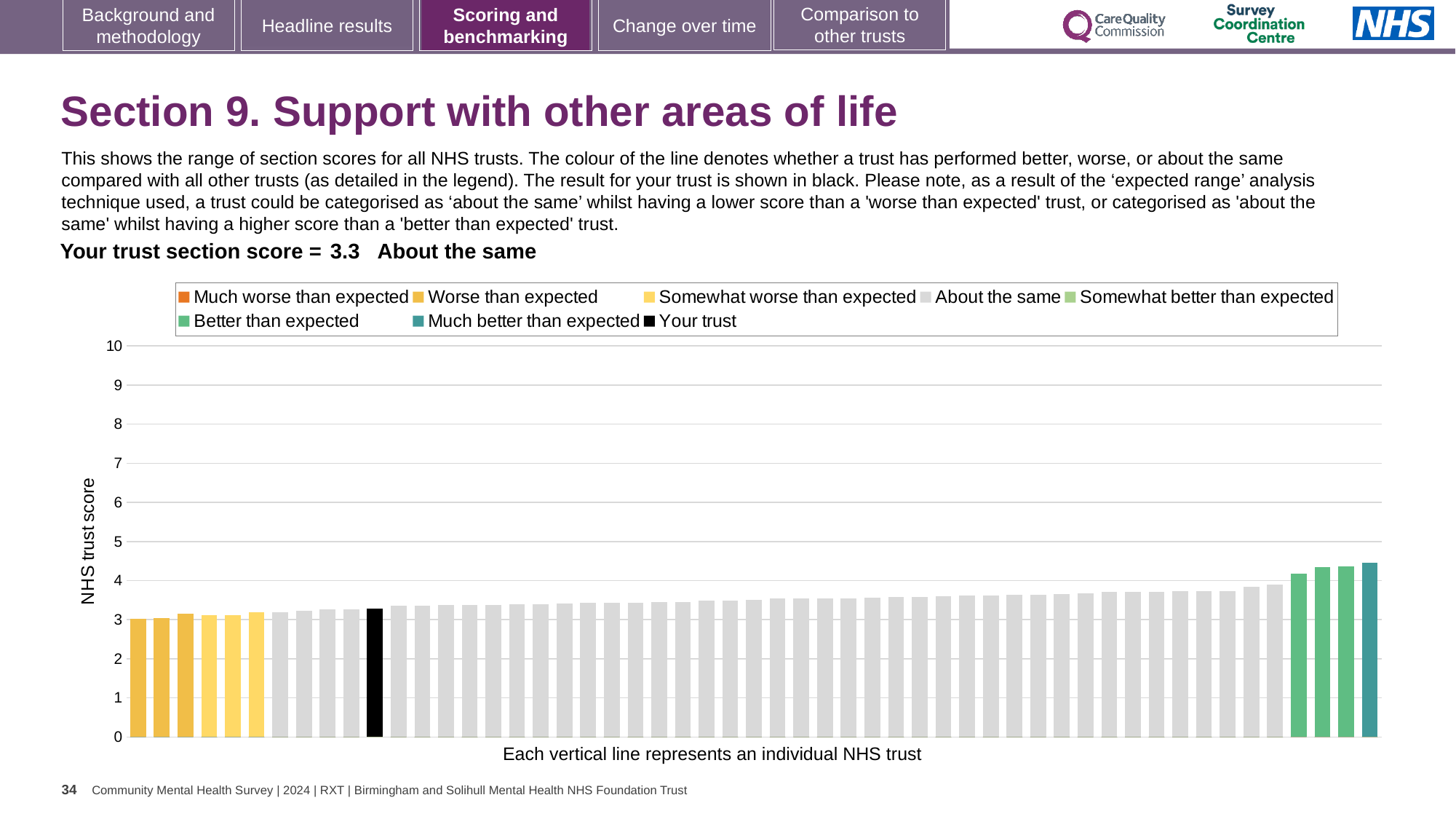
What is the label on the vertical axis of the chart? NHS trust score Which legend category does the tallest bar in the chart belong to? Much better than expected How many bars are coloured as 'Better than expected' (green)? 3 Is the value of the tallest bar in the chart greater or less than 4? greater How many entries does the chart legend list? 8 What colour is the bar representing your trust? black Is the value of the tallest bar in the chart greater or less than 5? less What kind of chart is shown on the slide? bar chart Do the bar values rise or fall from left to right along the x axis? rise How is your trust's section score categorised compared with other trusts? About the same What is the section score for your trust shown on the slide? 3.3 Is the value of the shortest bar in the chart greater or less than 2? greater